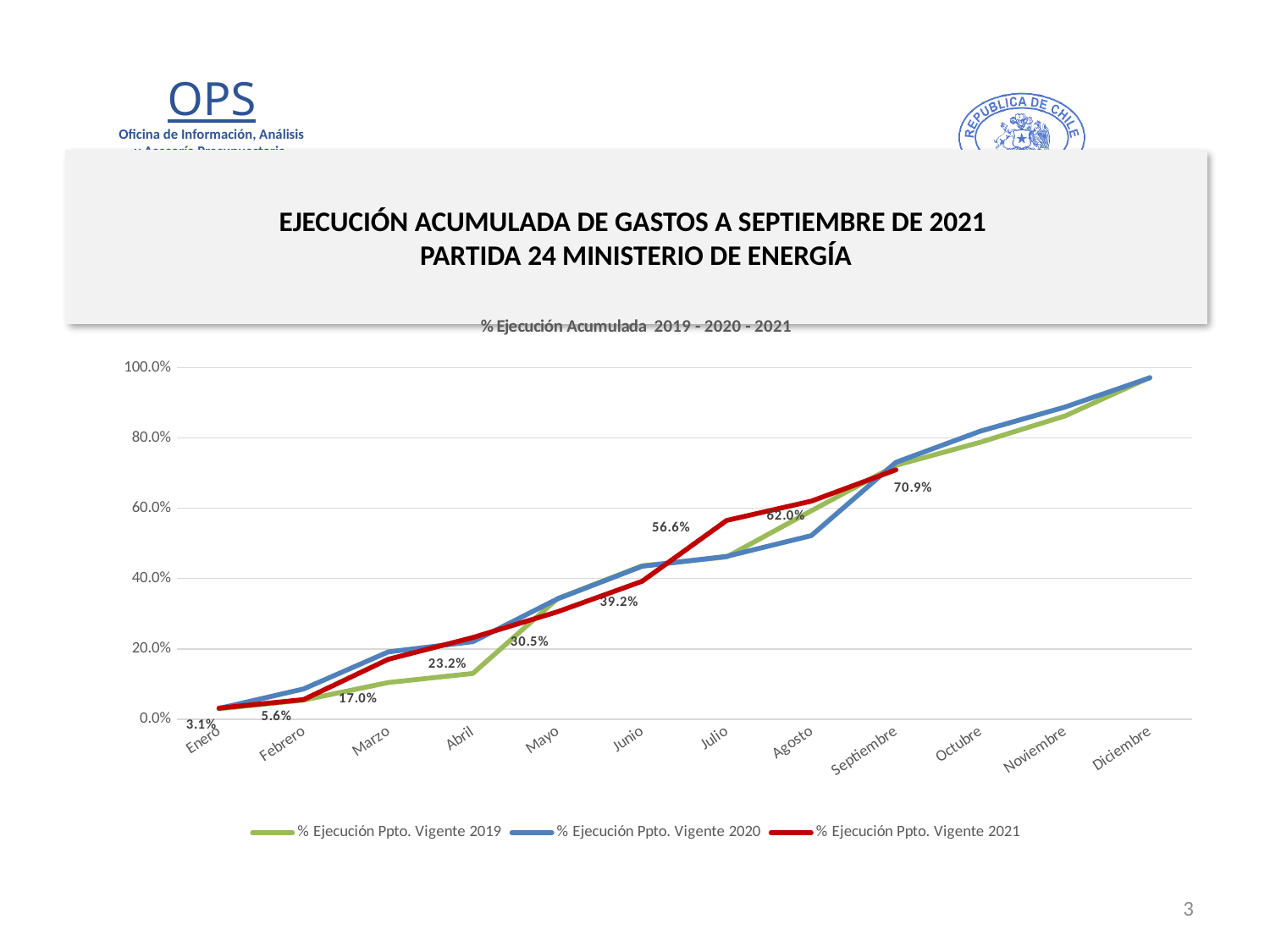
What is the difference between the Agosto and Julio values in the % Ejecución Ppto. Vigente 2021 series? 5.4% What kind of chart is shown on the slide? line chart What is the value for Septiembre in the % Ejecución Ppto. Vigente 2021 series? 70.9% Do the values of the % Ejecución Ppto. Vigente 2021 series rise or fall from Enero to Septiembre? rise What is the title of the chart? % Ejecución Acumulada 2019 - 2020 - 2021 Is the value for Diciembre in the % Ejecución Ppto. Vigente 2020 series greater or less than 80.0%? greater What is the value for Julio in the % Ejecución Ppto. Vigente 2021 series? 56.6% How many series does the legend list? 3 Which month has the lowest value in the % Ejecución Ppto. Vigente 2021 series? Enero What is the difference between the Septiembre and Enero values in the % Ejecución Ppto. Vigente 2021 series? 67.8% What is the value for Marzo in the % Ejecución Ppto. Vigente 2021 series? 17.0% How many months are shown on the x axis? 12